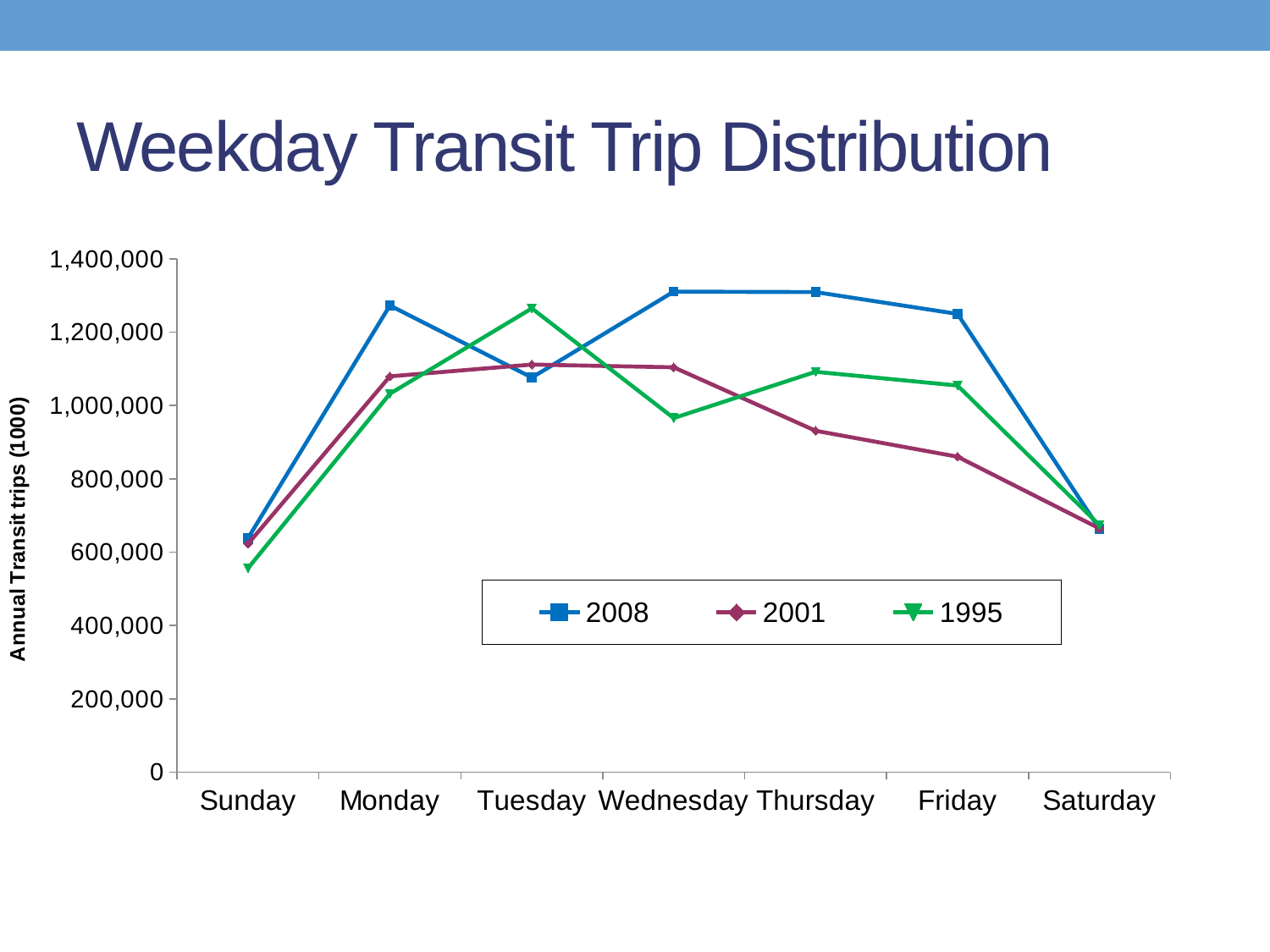
What is the label on the vertical axis? Annual Transit trips (1000) On Tuesday, which series has the larger value, 2008 or 1995? 1995 Which day has the lowest value for the 1995 series? Sunday What kind of chart is shown on the slide? line chart How many days are shown along the x axis? 7 Is the 2001 value for Friday greater or less than 1,000,000? less Does the 2001 series rise or fall from Wednesday to Saturday? fall Is the 2008 value for Wednesday greater or less than 1,200,000? greater Which day has the highest value for the 1995 series? Tuesday Is the 1995 value for Sunday greater or less than 600,000? less How many series does the legend list? 3